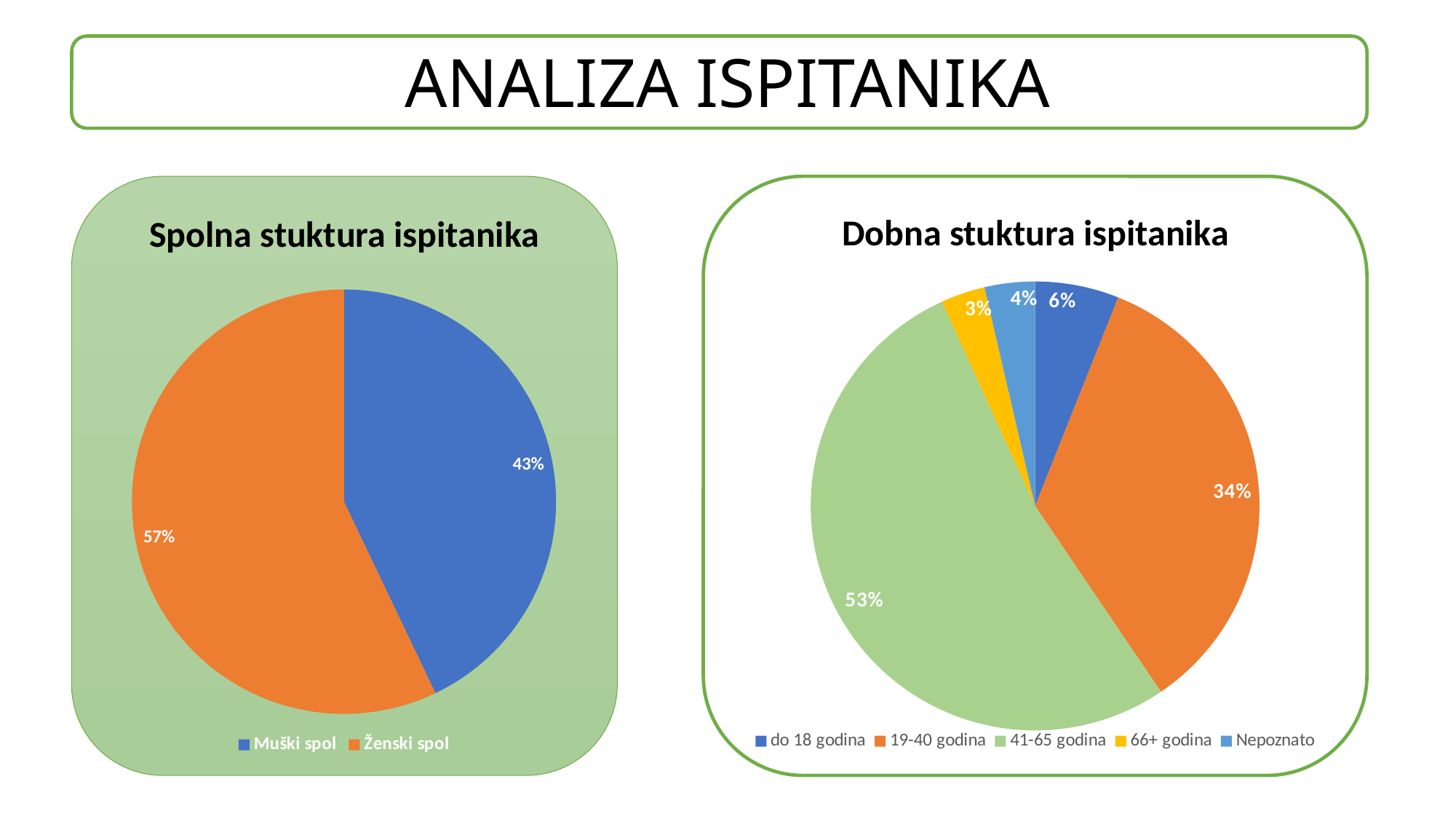
In the 'Dobna stuktura ispitanika' chart, what share is labelled for 19-40 godina? 34% How many categories does the legend of the 'Dobna stuktura ispitanika' chart list? 5 In the 'Spolna stuktura ispitanika' chart, what share is labelled for Ženski spol? 57% What kind of chart is 'Spolna stuktura ispitanika'? pie chart In the 'Spolna stuktura ispitanika' chart, what is the difference in percentage points between Ženski spol and Muški spol? 14 In the 'Dobna stuktura ispitanika' chart, what share is labelled for 41-65 godina? 53% In the 'Dobna stuktura ispitanika' chart, what share is labelled for 66+ godina? 3% In the 'Dobna stuktura ispitanika' chart, which is larger: do 18 godina or Nepoznato? do 18 godina In the 'Spolna stuktura ispitanika' chart, what share is labelled for Muški spol? 43% In the 'Spolna stuktura ispitanika' chart, which category has the larger slice? Ženski spol In the 'Dobna stuktura ispitanika' chart, which category has the smallest slice? 66+ godina In the 'Dobna stuktura ispitanika' chart, what is the difference in percentage points between 41-65 godina and 19-40 godina? 19